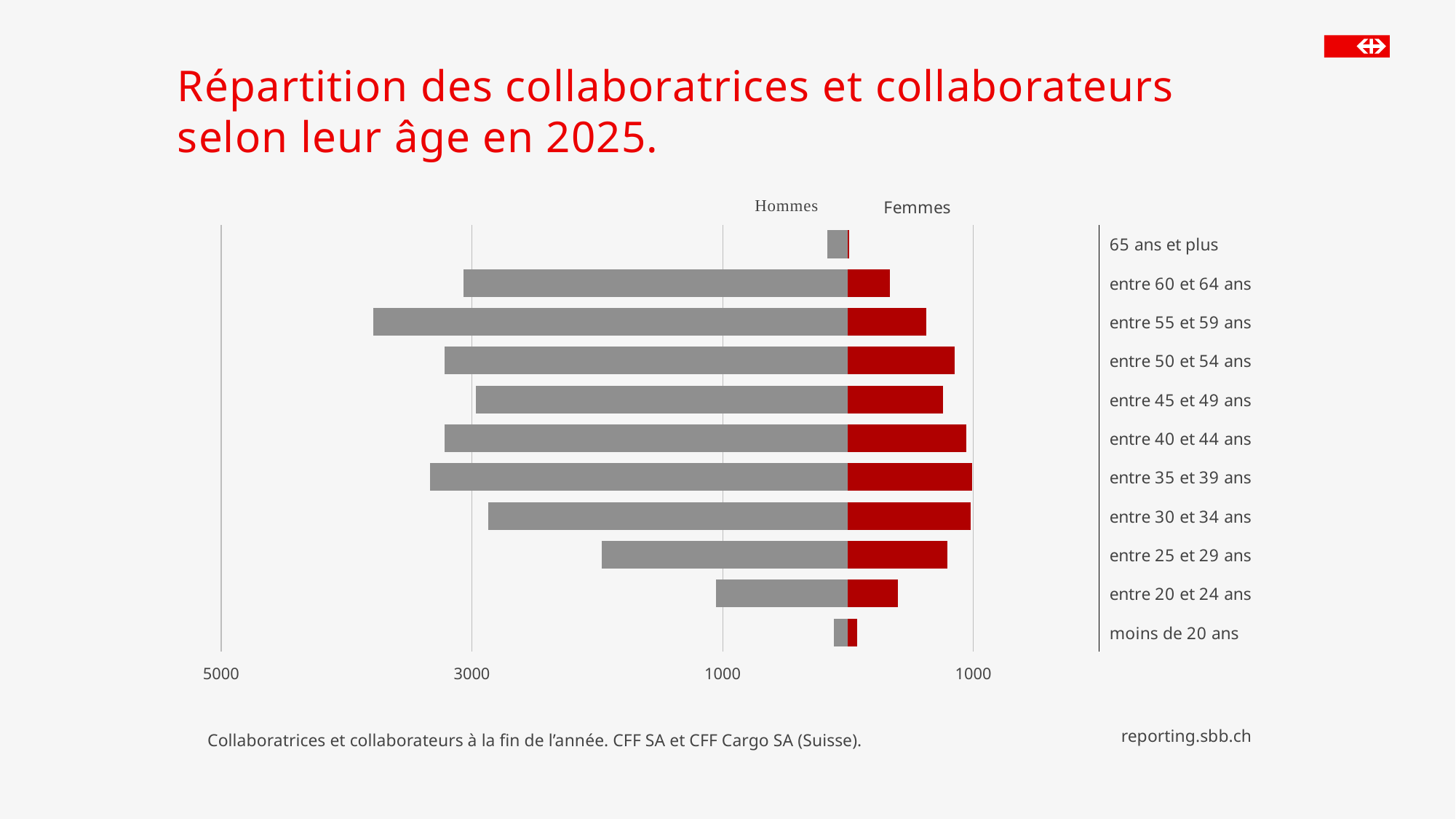
Is the Femmes value for 'entre 60 et 64 ans' greater or less than 1000? less Is the Hommes value for 'entre 55 et 59 ans' greater or less than 3000? greater Is the Hommes value for 'entre 25 et 29 ans' greater or less than 1000? greater Which age category has the lowest value for Femmes? 65 ans et plus Which age category has the highest value for Hommes? entre 55 et 59 ans What is the title of the slide? Répartition des collaboratrices et collaborateurs selon leur âge en 2025. How many age categories are shown in the chart? 11 What colour are the Femmes bars in the chart? red For 'entre 40 et 44 ans', which series has the larger value, Hommes or Femmes? Hommes How many series does the chart show? 2 What kind of chart is shown on the slide? bar chart Which is larger for Hommes: 'entre 55 et 59 ans' or 'entre 25 et 29 ans'? entre 55 et 59 ans